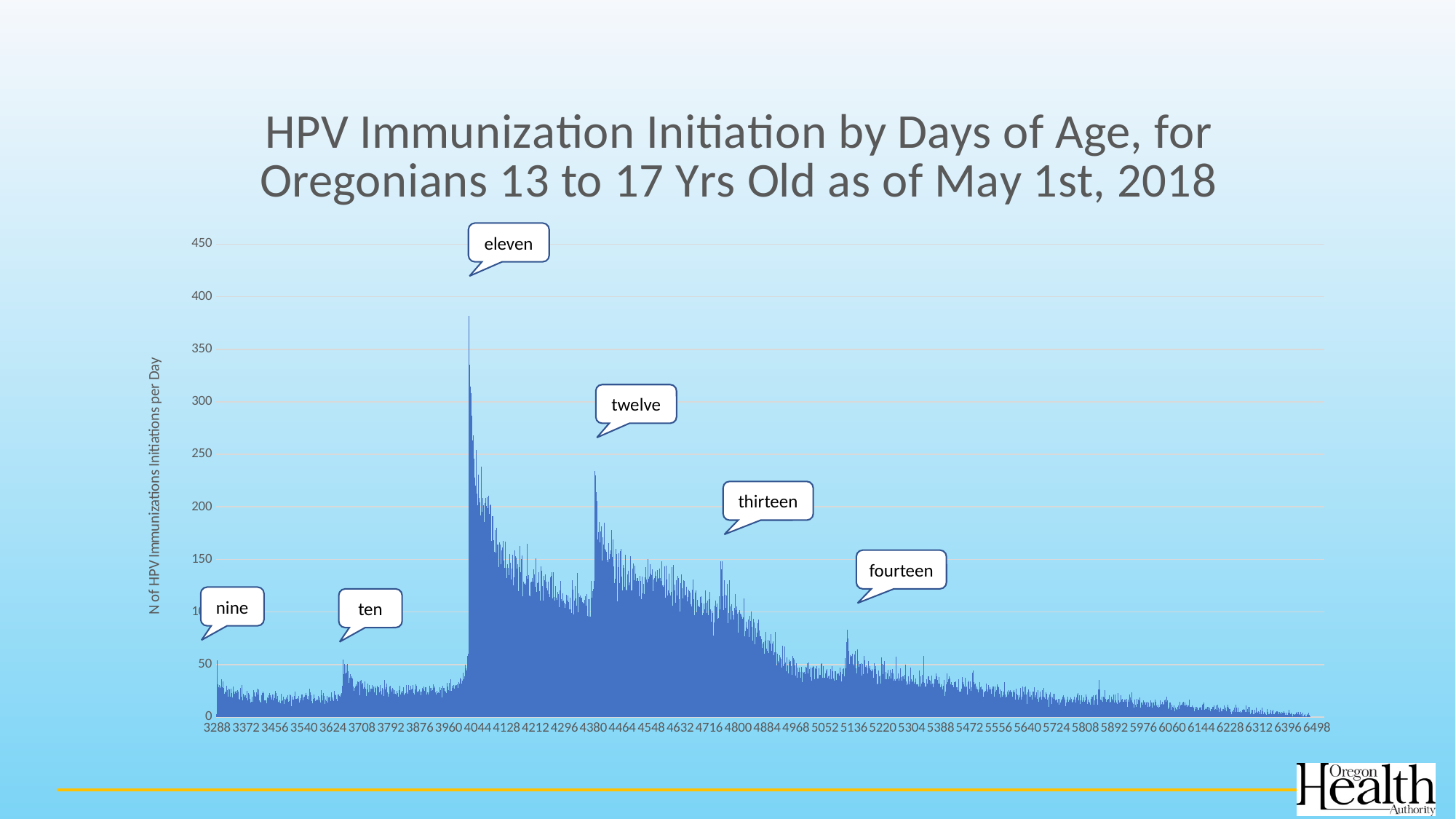
What is the title of the chart? HPV Immunization Initiation by Days of Age, for Oregonians 13 to 17 Yrs Old as of May 1st, 2018 Is the peak at the age labeled 'twelve' greater or less than 200 initiations per day? greater Is the peak at the age labeled 'fourteen' greater or less than 100 initiations per day? less Is the peak at the age labeled 'ten' greater or less than 100 initiations per day? less Which labeled age has the highest peak in daily HPV immunization initiations? eleven Which peak is higher, the one labeled 'eleven' or the one labeled 'twelve'? eleven What is the label on the vertical axis of the chart? N of HPV Immunizations Initiations per Day After the peak at age eleven, do daily initiations generally rise or fall as days of age increase? fall How many age callout labels are shown on the chart? 6